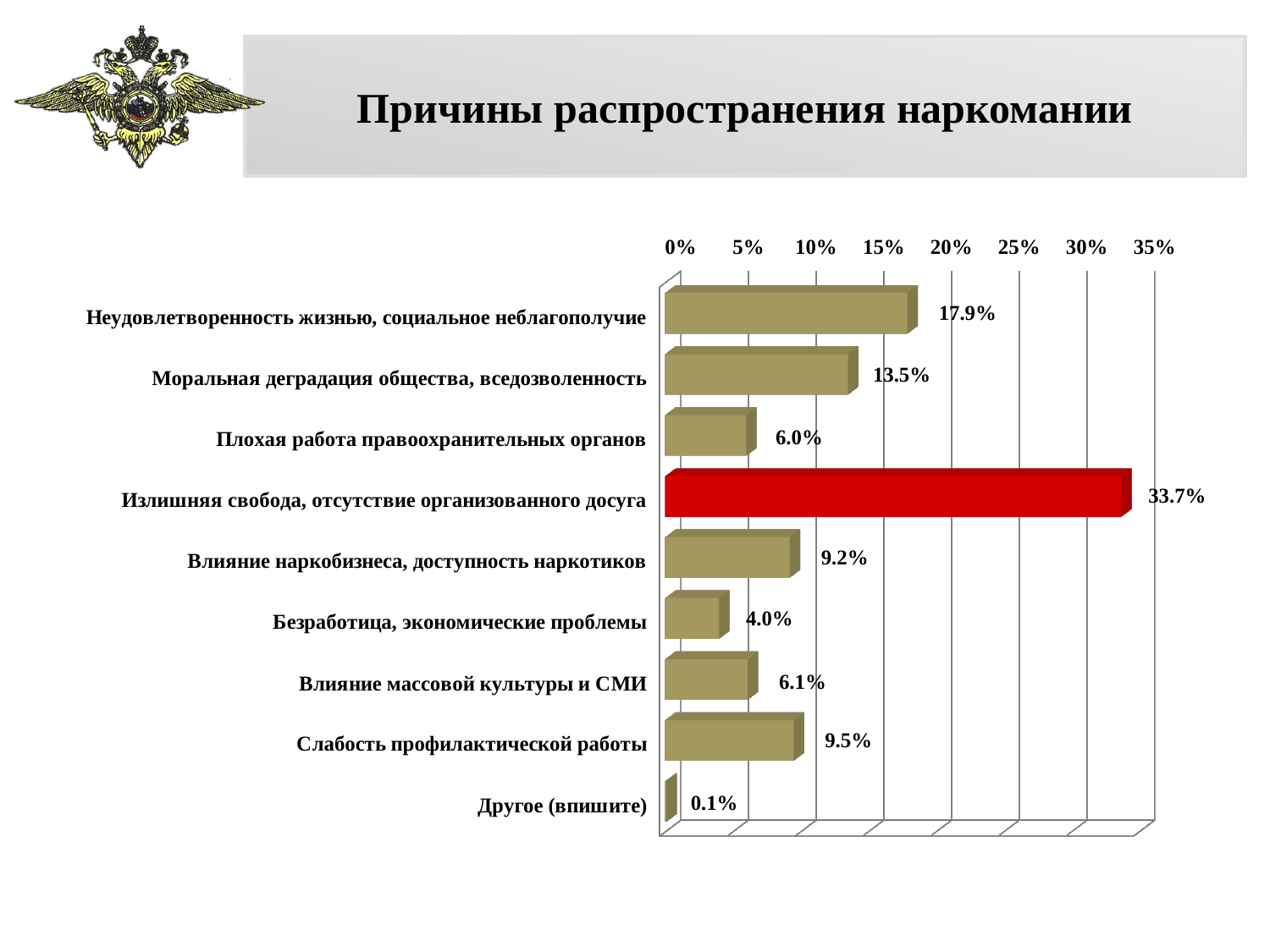
How many categories are shown in the chart? 9 What kind of chart is shown on the slide? bar chart What is the value for «Слабость профилактической работы»? 9.5% Is the value for «Неудовлетворенность жизнью, социальное неблагополучие» greater or less than 15%? greater Which category has the highest value? Излишняя свобода, отсутствие организованного досуга What is the value for «Излишняя свобода, отсутствие организованного досуга»? 33.7% Which bar is coloured red instead of the others' colour? Излишняя свобода, отсутствие организованного досуга What is the value for «Моральная деградация общества, вседозволенность»? 13.5% What is the difference between «Неудовлетворенность жизнью, социальное неблагополучие» and «Моральная деградация общества, вседозволенность»? 4.4% What is the title of the slide? Причины распространения наркомании Which category has the lowest value? Другое (впишите) Which is larger: «Влияние наркобизнеса, доступность наркотиков» or «Слабость профилактической работы»? Слабость профилактической работы